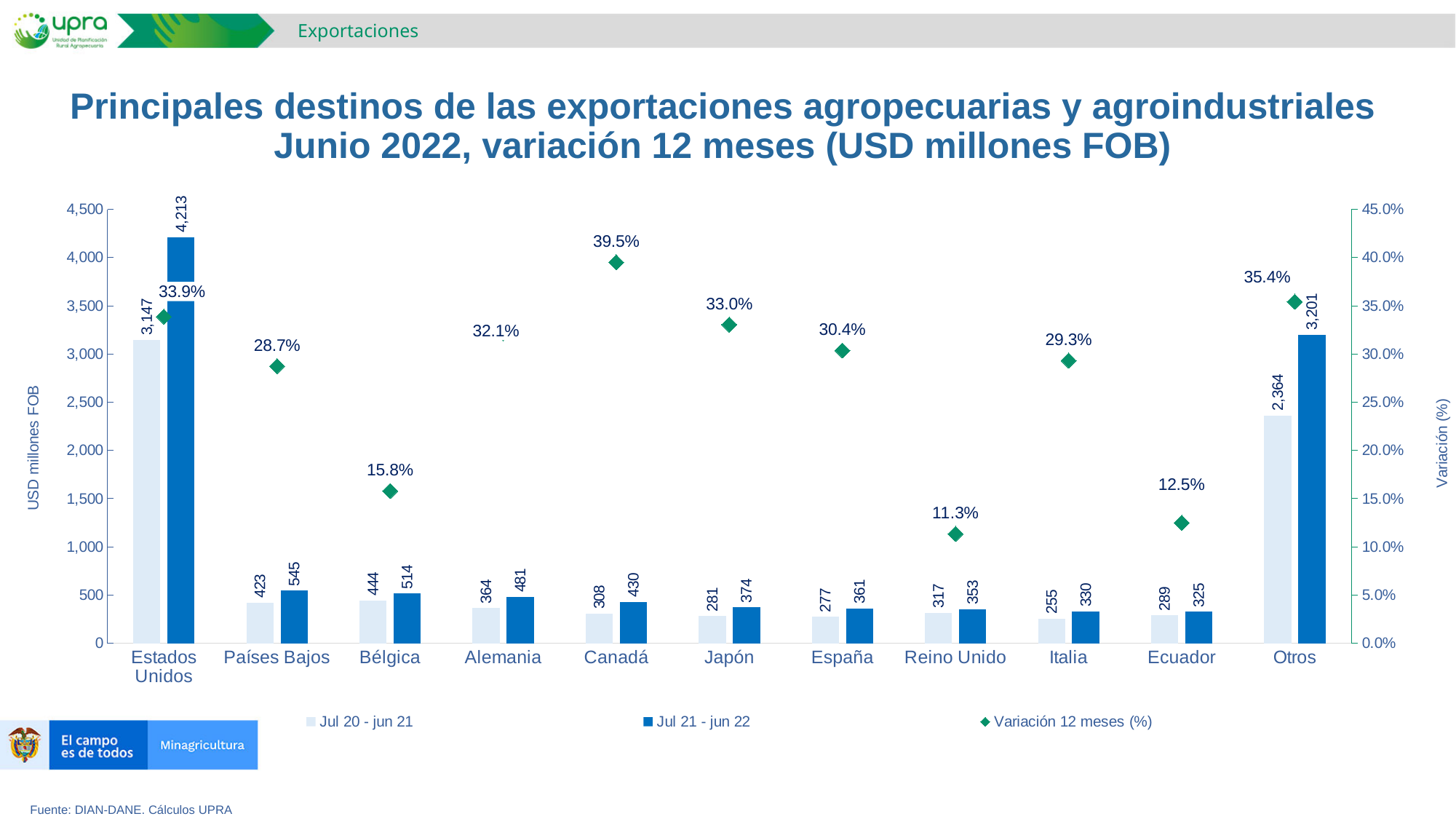
What is the Variación 12 meses (%) for Bélgica? 15.8% What is the Jul 21 - jun 22 value for Estados Unidos? 4,213 Which has the larger Jul 21 - jun 22 value, Países Bajos or Bélgica? Países Bajos What is the difference between the Jul 21 - jun 22 and Jul 20 - jun 21 values for Estados Unidos? 1,066 What is the Jul 21 - jun 22 value for Otros? 3,201 How many series does the legend list? 3 How many destination categories are shown on the x axis? 11 What is the difference between the Jul 21 - jun 22 and Jul 20 - jun 21 values for Alemania? 117 Which destination has the lowest Variación 12 meses (%)? Reino Unido Which destination has the highest Variación 12 meses (%)? Canadá Which destination has the lowest Jul 20 - jun 21 value? Italia What is the Jul 20 - jun 21 value for Canadá? 308